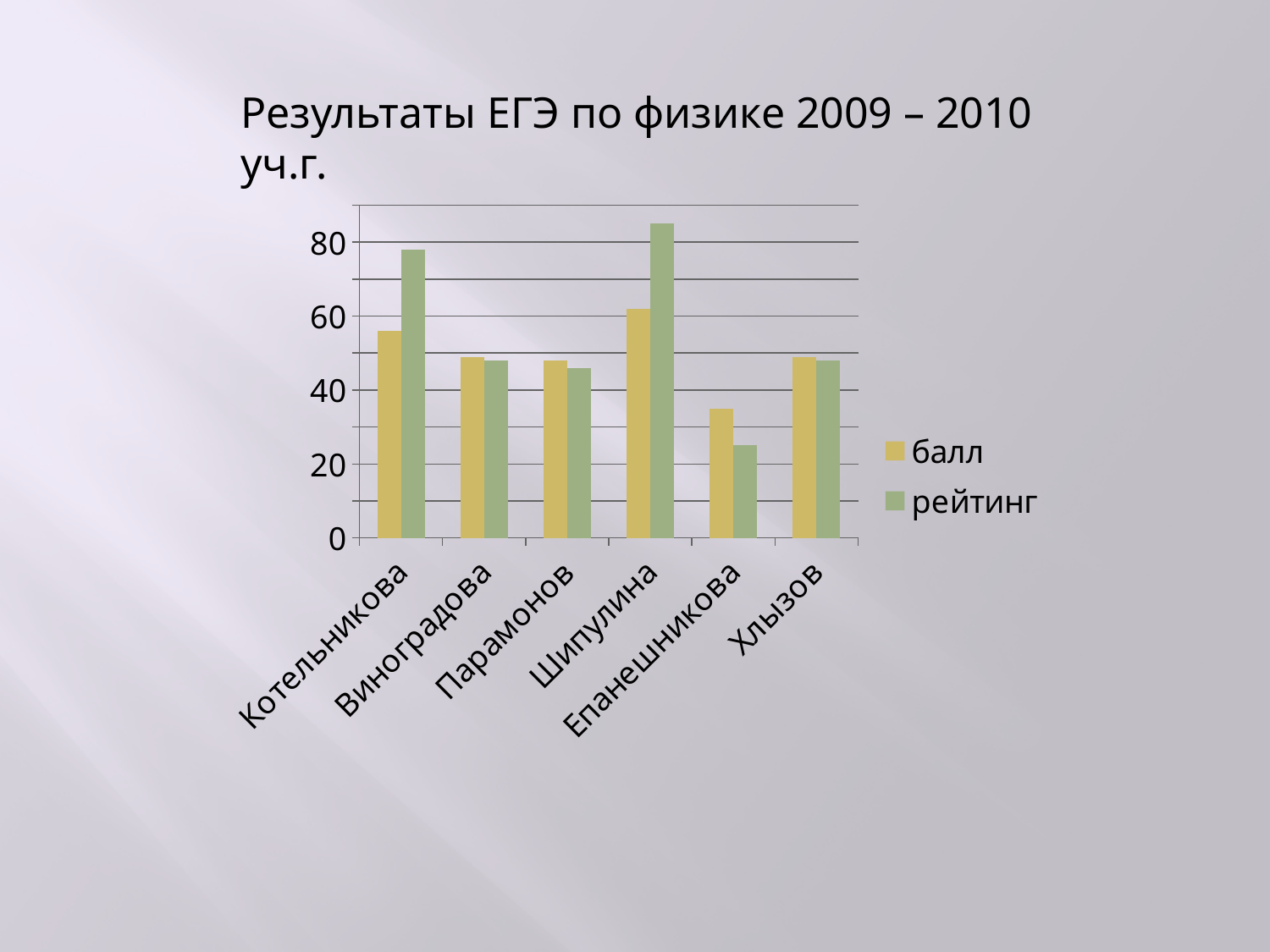
For Епанешникова, which is larger: балл or рейтинг? балл What is the title of the chart? Результаты ЕГЭ по физике 2009 – 2010 уч.г. Which student has the highest рейтинг value? Шипулина For Котельникова, which is larger: балл or рейтинг? рейтинг Which student has the lowest балл value? Епанешникова Is the рейтинг value for Шипулина greater or less than 80? greater Is the рейтинг value for Котельникова greater or less than 60? greater Is the балл value for Епанешникова greater or less than 40? less How many series does the legend list? 2 How many students (categories) are shown on the x axis? 6 What kind of chart is shown on the slide? bar chart Which student has the lowest рейтинг value? Епанешникова